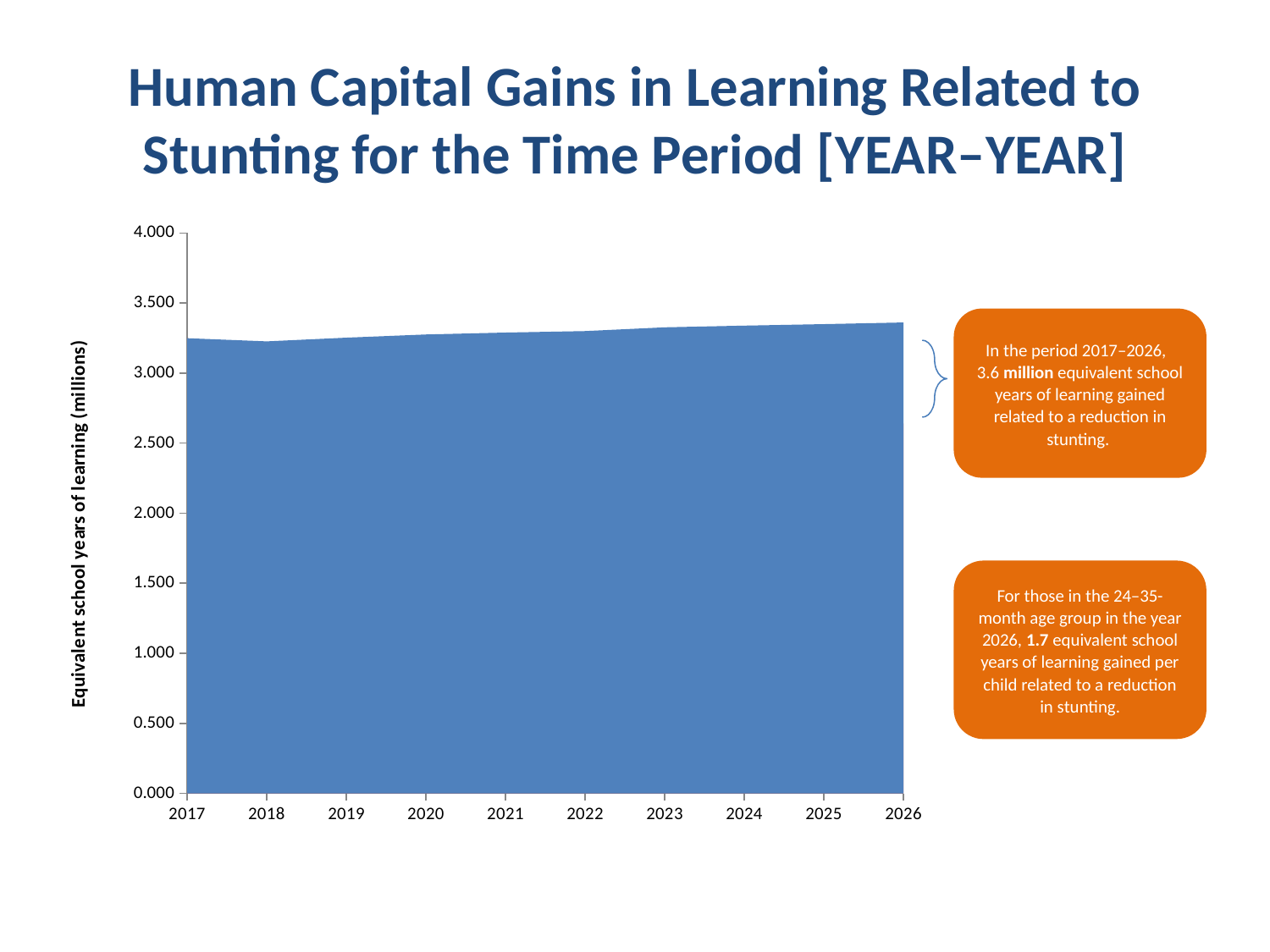
What is the last year shown on the x axis of the chart? 2026 Which year has the larger value, 2018 or 2026? 2026 Do the values generally rise or fall from 2018 to 2026? rise What is the first year shown on the x axis of the chart? 2017 What is the highest tick value shown on the y axis of the chart? 4.000 Is the value for 2017 greater or less than 3.000? greater How many years are plotted along the x axis of the chart? 10 Is the value for 2026 greater or less than 3.500? less Is the value for 2018 greater or less than 3.500? less What kind of chart is shown on the slide? Area chart